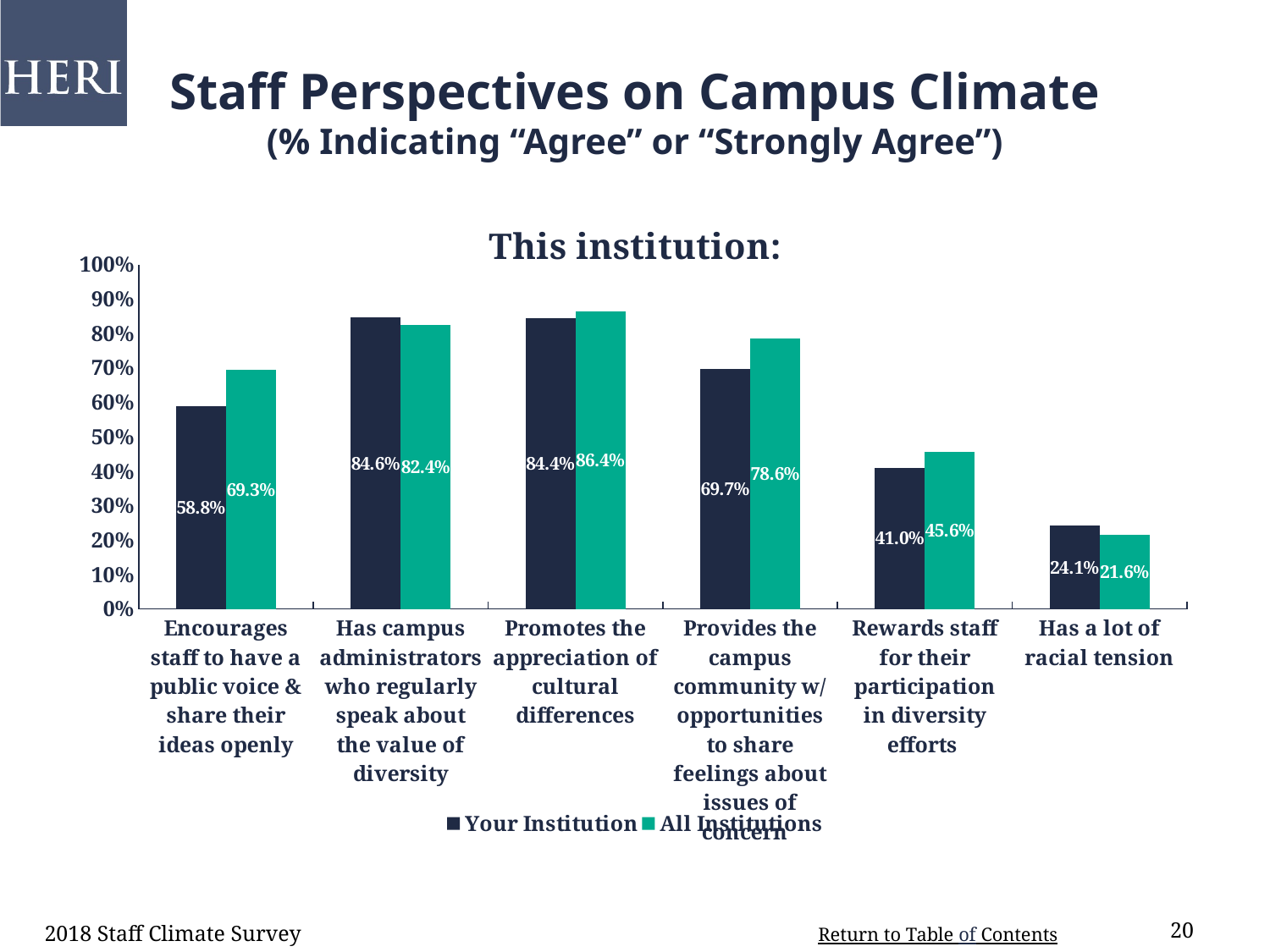
Which category has the highest value for "All Institutions"? Promotes the appreciation of cultural differences What kind of chart is shown on the slide? Bar chart Which category has the lowest value for "Your Institution"? Has a lot of racial tension On "Has campus administrators who regularly speak about the value of diversity", which is larger: "Your Institution" or "All Institutions"? Your Institution Is the value for "Your Institution" on "Provides the campus community w/ opportunities to share feelings about issues of concern" greater or less than 60%? greater What is the difference between "All Institutions" and "Your Institution" on "Encourages staff to have a public voice & share their ideas openly"? 10.5 percentage points What is the value for "Your Institution" on "Has a lot of racial tension"? 24.1% What is the value for "All Institutions" on "Promotes the appreciation of cultural differences"? 86.4% What is the difference between "All Institutions" and "Your Institution" on "Provides the campus community w/ opportunities to share feelings about issues of concern"? 8.9 percentage points What is the value for "Your Institution" on "Rewards staff for their participation in diversity efforts"? 41.0% How many categories are shown on the x axis? 6 How many series does the legend list? 2